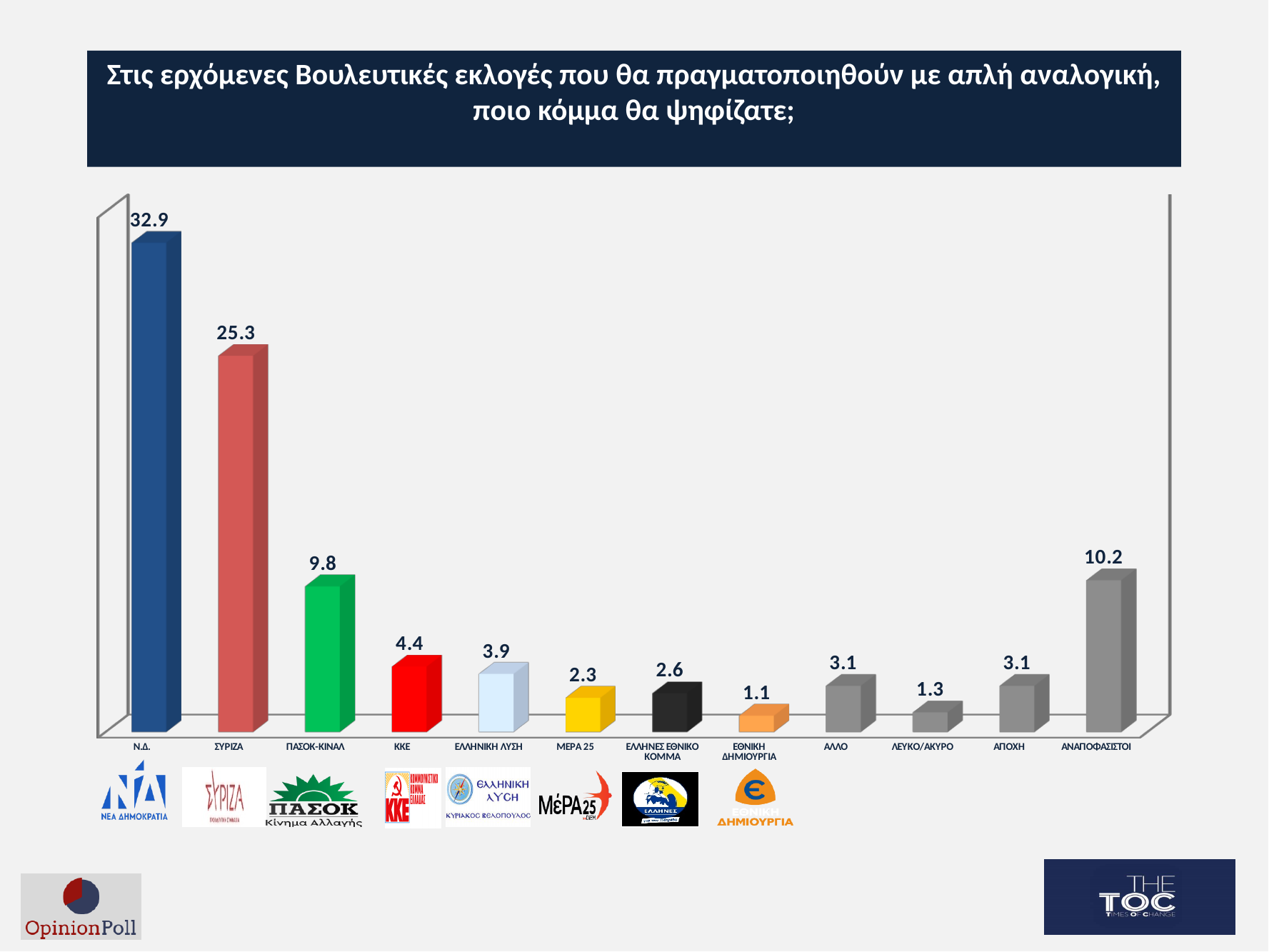
What is the difference between the values for Ν.Δ. and ΣΥΡΙΖΑ? 7.6 What is the value for ΚΚΕ? 4.4 What is the value for ΑΝΑΠΟΦΑΣΙΣΤΟΙ? 10.2 What is the value for ΣΥΡΙΖΑ? 25.3 What is the value for Ν.Δ.? 32.9 How many categories are shown in the chart? 12 Which is larger, the value for ΕΛΛΗΝΙΚΗ ΛΥΣΗ or the value for ΜΕΡΑ 25? ΕΛΛΗΝΙΚΗ ΛΥΣΗ Which category has the highest value? Ν.Δ. Which category has the lowest value? ΕΘΝΙΚΗ ΔΗΜΙΟΥΡΓΙΑ Which is larger, the value for ΑΝΑΠΟΦΑΣΙΣΤΟΙ or the value for ΠΑΣΟΚ-ΚΙΝΑΛ? ΑΝΑΠΟΦΑΣΙΣΤΟΙ What is the difference between the values for ΠΑΣΟΚ-ΚΙΝΑΛ and ΚΚΕ? 5.4 What kind of chart is shown on the slide? Bar chart